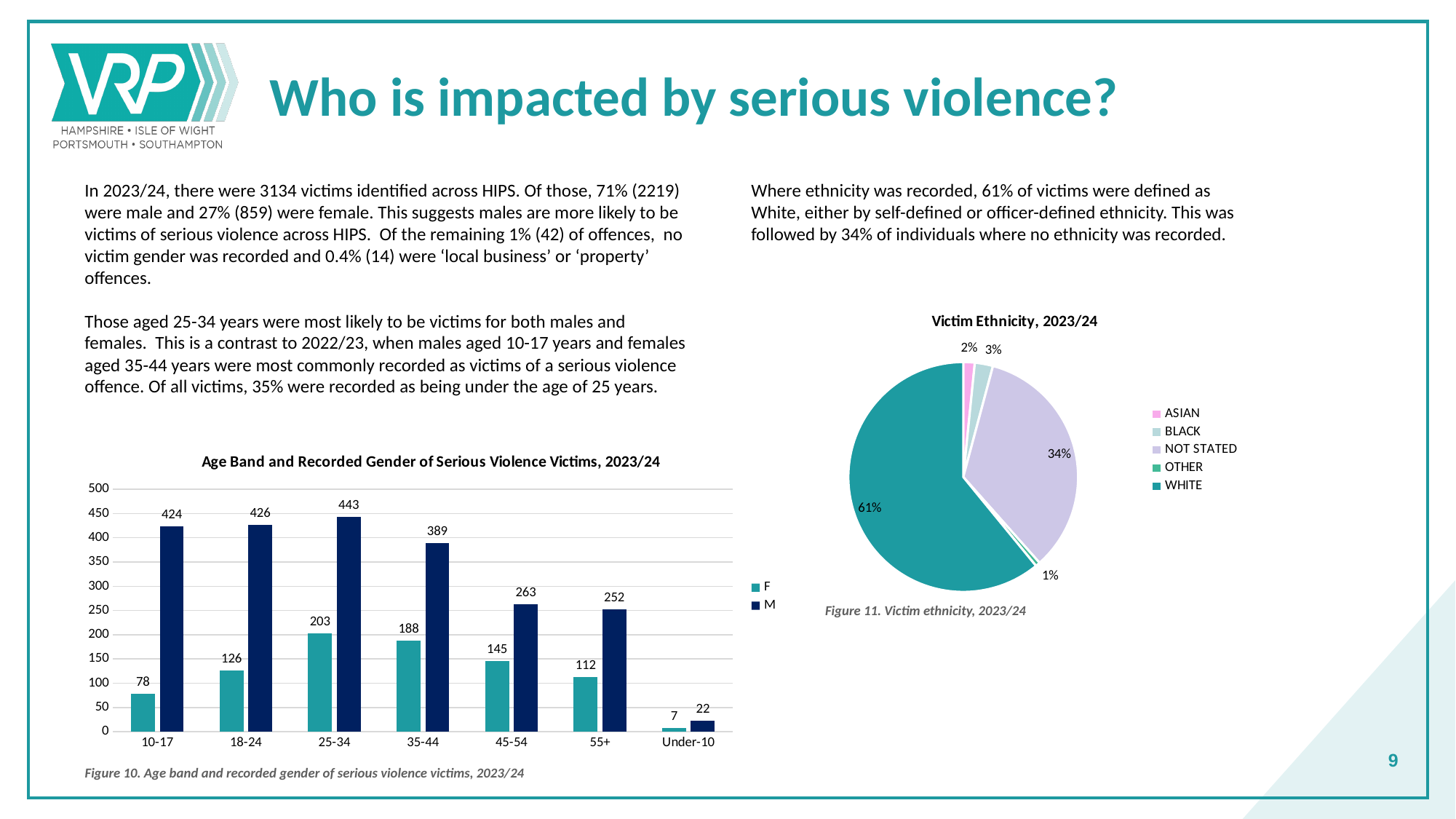
What kind of chart is the 'Age Band and Recorded Gender of Serious Violence Victims, 2023/24' chart? Bar chart In the 'Age Band and Recorded Gender of Serious Violence Victims, 2023/24' chart, which age band has the highest value for F? 25-34 How many series does the legend of the 'Age Band and Recorded Gender of Serious Violence Victims, 2023/24' chart list? 2 In the 'Age Band and Recorded Gender of Serious Violence Victims, 2023/24' chart, what is the difference between the M and F values for the 10-17 age band? 346 In the 'Age Band and Recorded Gender of Serious Violence Victims, 2023/24' chart, what is the value for F in the 35-44 age band? 188 How many age bands are shown in the 'Age Band and Recorded Gender of Serious Violence Victims, 2023/24' chart? 7 In the 'Victim Ethnicity, 2023/24' pie chart, which category has the largest slice? WHITE In the 'Age Band and Recorded Gender of Serious Violence Victims, 2023/24' chart, what is the value for M in the 25-34 age band? 443 In the 'Victim Ethnicity, 2023/24' pie chart, what share of victims is NOT STATED? 34% In the 'Age Band and Recorded Gender of Serious Violence Victims, 2023/24' chart, which age band has the lowest value for M? Under-10 In the 'Age Band and Recorded Gender of Serious Violence Victims, 2023/24' chart, which is larger: the M value for 45-54 or the M value for 55+? 45-54 How many categories does the legend of the 'Victim Ethnicity, 2023/24' pie chart list? 5